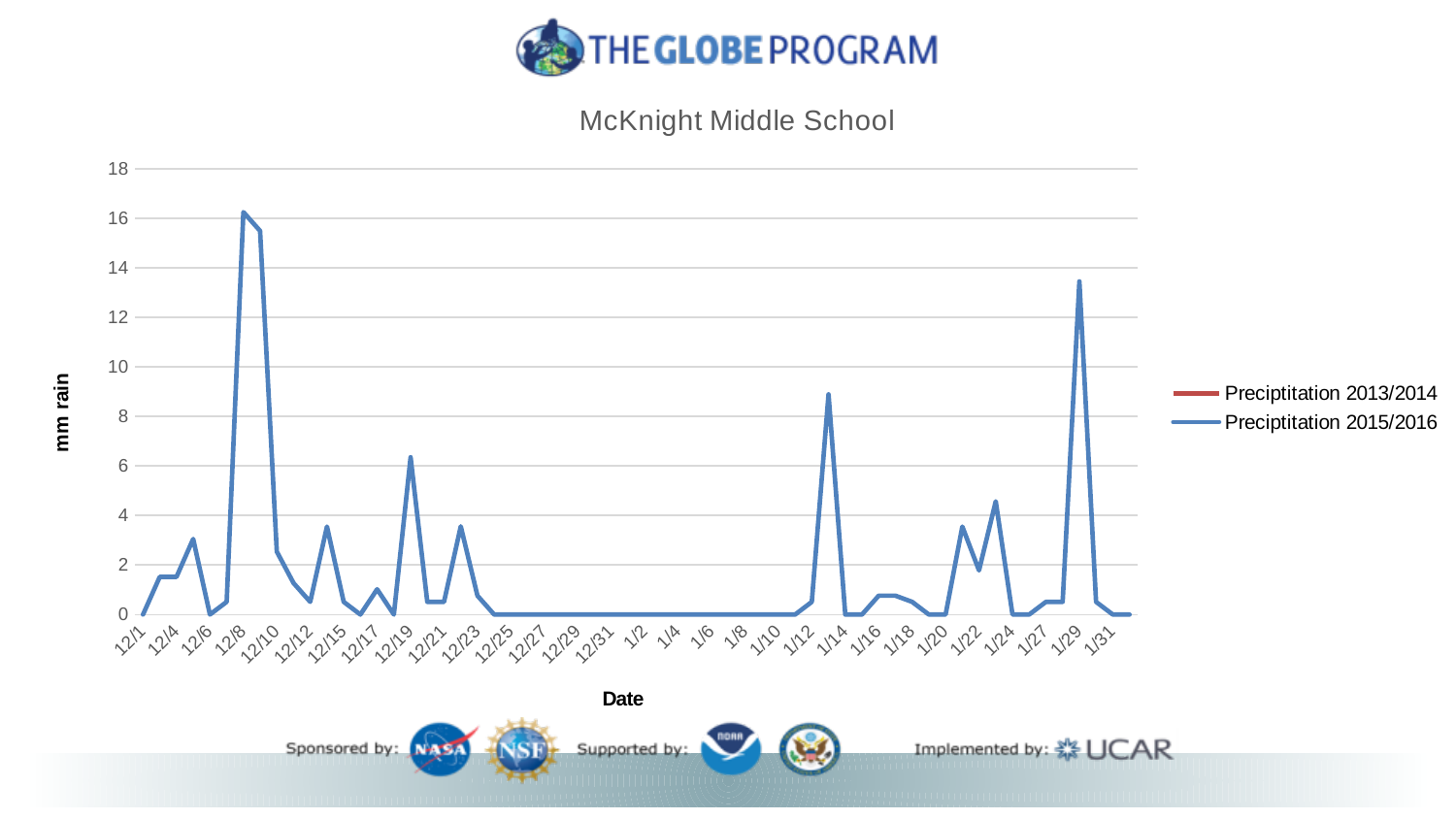
Which date has the larger Preciptitation 2015/2016 value, 12/19 or 12/23? 12/19 Is the Preciptitation 2015/2016 value on 1/29 greater or less than 12? greater What is the label on the vertical axis of the chart? mm rain Is the Preciptitation 2015/2016 value on 12/8 greater or less than 14? greater On which date does the Preciptitation 2015/2016 line reach its highest value? 12/8 What is the title of the chart? McKnight Middle School How many series does the legend list? 2 What type of chart is shown on the slide? Line chart Which date has the larger Preciptitation 2015/2016 value, 12/8 or 1/29? 12/8 Is the Preciptitation 2015/2016 value on 12/23 greater or less than 4? less